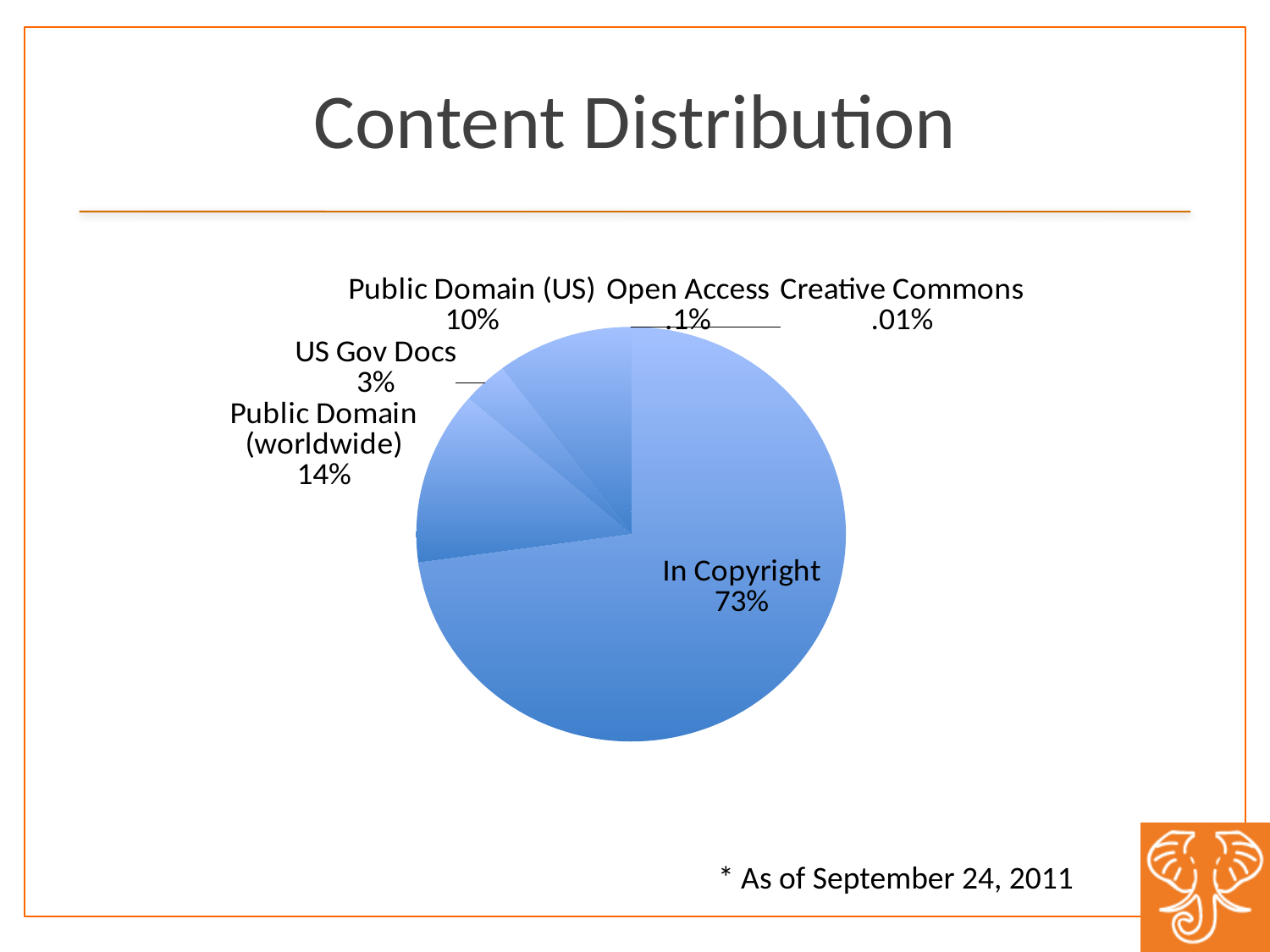
Which is larger, Public Domain (US) or US Gov Docs? Public Domain (US) What share of the pie does In Copyright hold? 73% What kind of chart is shown on the slide? Pie chart What is the value shown for Public Domain (US)? 10% Which category has the smallest slice of the pie? Creative Commons What is the value shown for Creative Commons? .01% What is the value shown for Public Domain (worldwide)? 14% What is the value shown for US Gov Docs? 3% How many categories are shown in the pie chart? 6 Which category has the largest slice of the pie? In Copyright What is the value shown for Open Access? .1% What is the difference between the In Copyright share and the Public Domain (worldwide) share? 59%